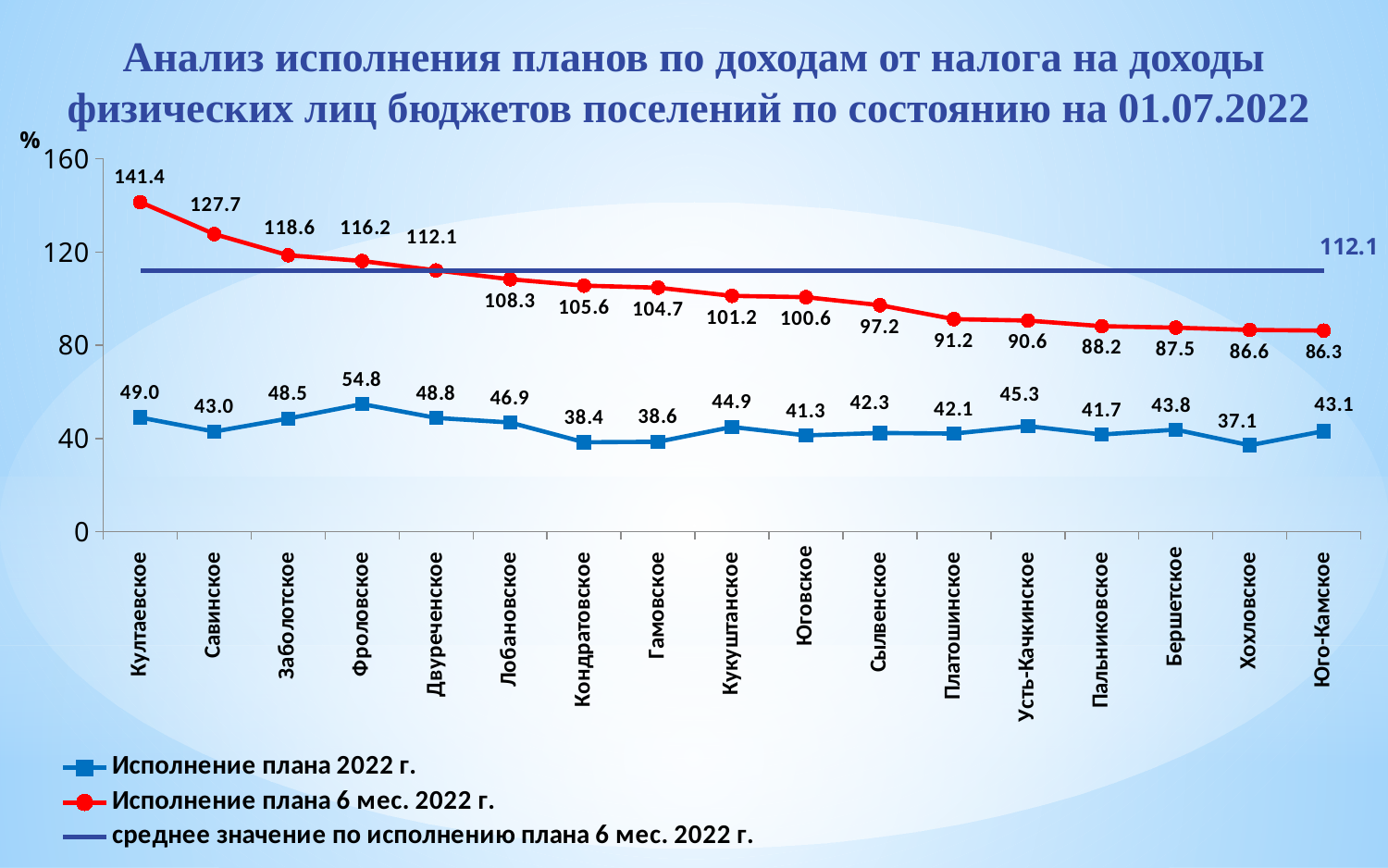
How many series does the legend list? 3 How many categories (settlements) are shown on the x axis? 17 Is the 'Исполнение плана 6 мес. 2022 г.' value for Сылвенское greater or less than 120? less What is the value of the horizontal line 'среднее значение по исполнению плана 6 мес. 2022 г.'? 112.1 Which category has the highest value for 'Исполнение плана 6 мес. 2022 г.'? Култаевское Which category has the lowest value for 'Исполнение плана 2022 г.'? Хохловское What kind of chart is shown on the slide? line chart What is the difference between the 'Исполнение плана 6 мес. 2022 г.' values for Култаевское and Юго-Камское? 55.1 What is the value of 'Исполнение плана 2022 г.' for Фроловское? 54.8 What is the value of 'Исполнение плана 6 мес. 2022 г.' for Култаевское? 141.4 Does the 'Исполнение плана 6 мес. 2022 г.' series rise or fall from left to right along the x axis? fall Which is larger: the 'Исполнение плана 2022 г.' value for Кондратовское or for Кукуштанское? Кукуштанское